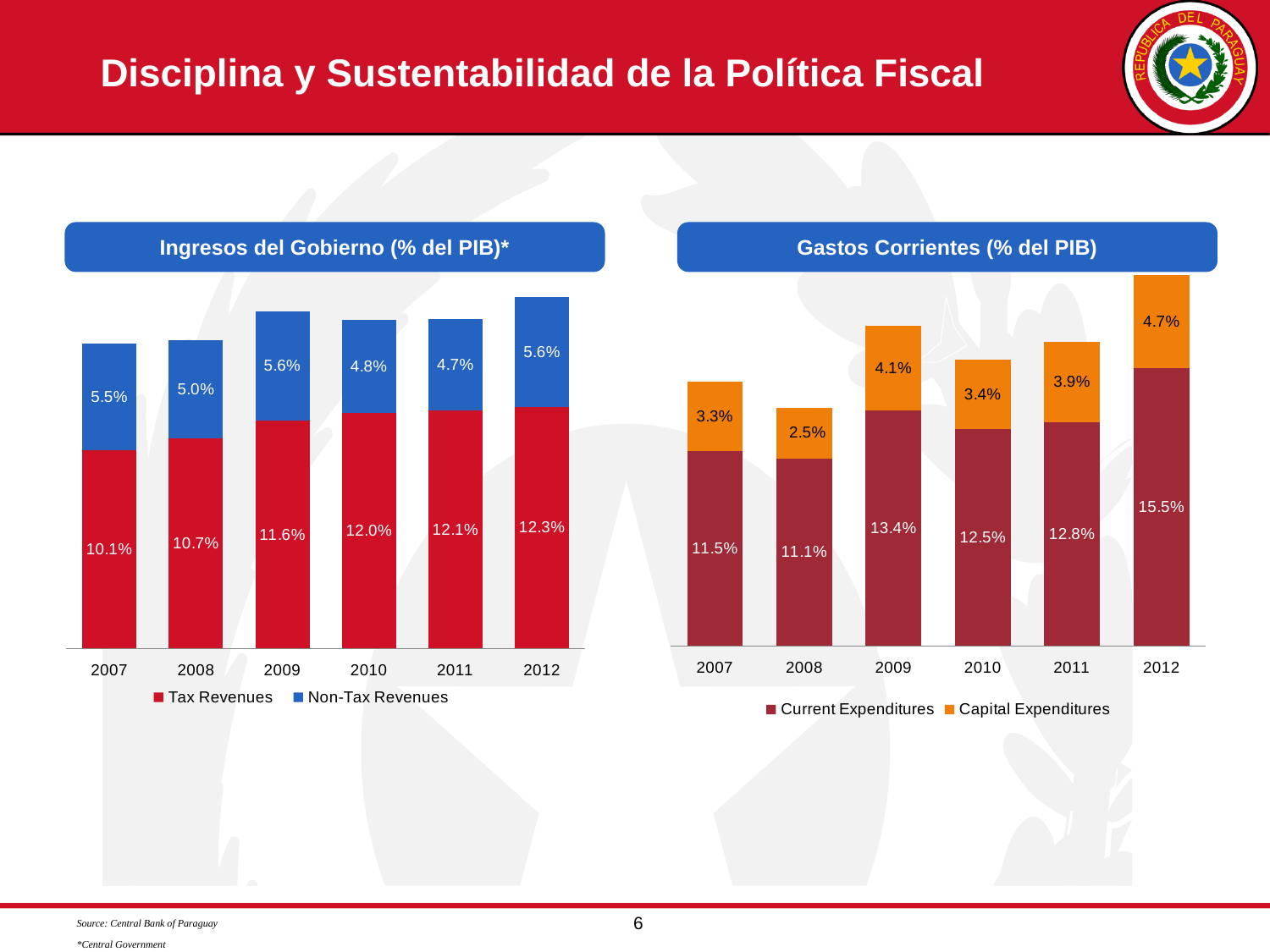
In the 'Gastos Corrientes (% del PIB)' chart, what is the Capital Expenditures value for 2011? 3.9% What kind of chart is the 'Gastos Corrientes (% del PIB)' chart? Stacked bar chart In the 'Gastos Corrientes (% del PIB)' chart, what is the total of the stacked bar for 2012? 20.2% In the 'Ingresos del Gobierno (% del PIB)*' chart, which year has the highest Tax Revenues value? 2012 In the 'Gastos Corrientes (% del PIB)' chart, is Capital Expenditures larger in 2009 or 2010? 2009 In the 'Ingresos del Gobierno (% del PIB)*' chart, how many series does the legend list? 2 In the 'Ingresos del Gobierno (% del PIB)*' chart, what is the Tax Revenues value for 2010? 12.0% In the 'Gastos Corrientes (% del PIB)' chart, what is the Current Expenditures value for 2009? 13.4% In the 'Gastos Corrientes (% del PIB)' chart, which year has the lowest Current Expenditures value? 2008 In the 'Ingresos del Gobierno (% del PIB)*' chart, what is the total of the stacked bar for 2012? 17.9% In the 'Ingresos del Gobierno (% del PIB)*' chart, what is the difference between Tax Revenues in 2012 and 2007? 2.2% In the 'Ingresos del Gobierno (% del PIB)*' chart, what is the Non-Tax Revenues value for 2008? 5.0%